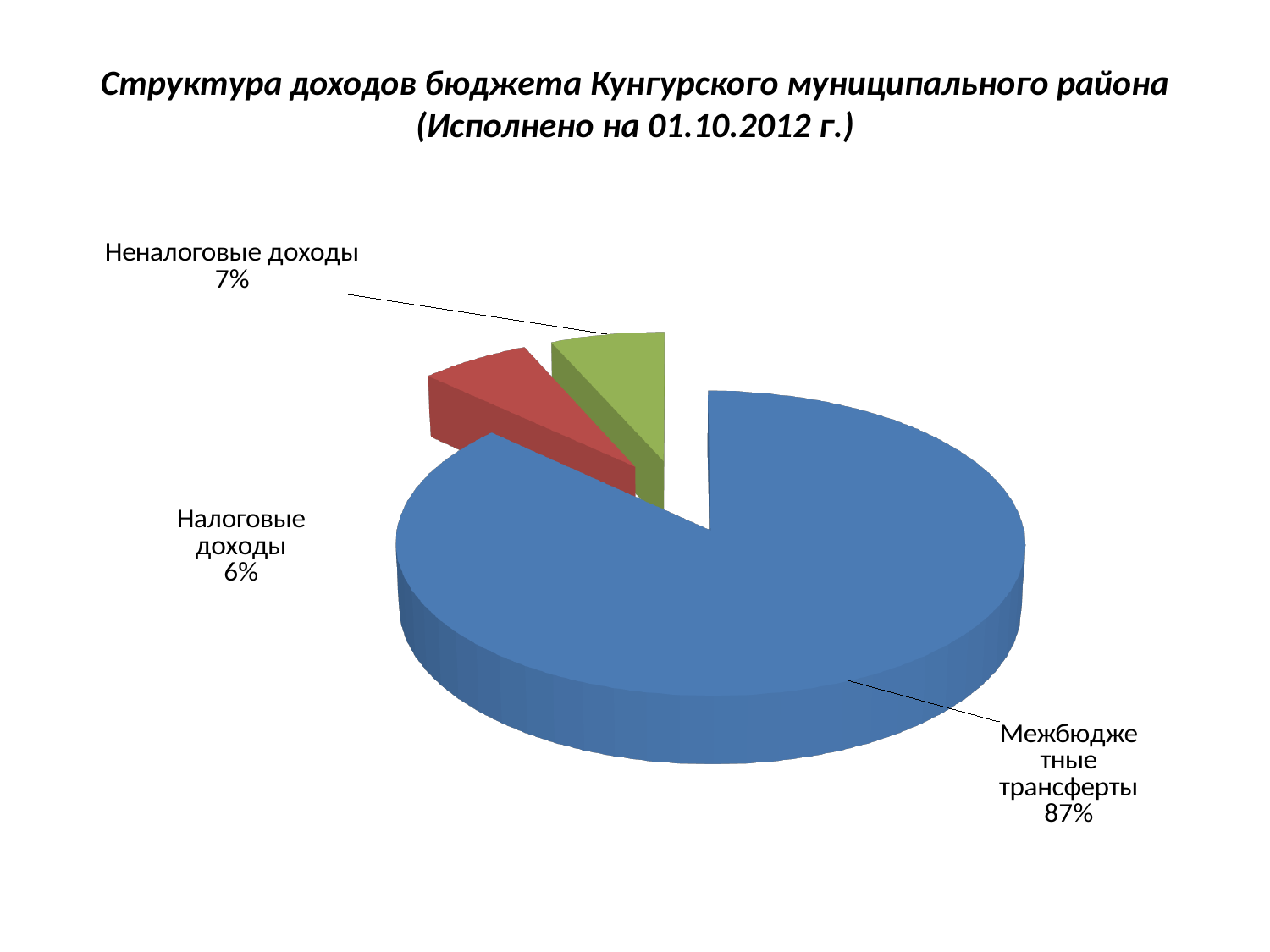
Which category has the smallest share of the pie? Налоговые доходы How many slices does the pie chart have? 3 What share of the pie does Неналоговые доходы hold? 7% What colour is the slice for Межбюджетные трансферты? Blue What is the difference in percentage points between Неналоговые доходы and Налоговые доходы? 1 Which category has the largest share of the pie? Межбюджетные трансферты What kind of chart is shown on the slide? Pie chart What is the title of the chart? Структура доходов бюджета Кунгурского муниципального района (Исполнено на 01.10.2012 г.) What share of the pie does Межбюджетные трансферты hold? 87% What share of the pie does Налоговые доходы hold? 6% What is the difference in percentage points between Межбюджетные трансферты and Неналоговые доходы? 80 Which is larger: the share of Неналоговые доходы or the share of Налоговые доходы? Неналоговые доходы